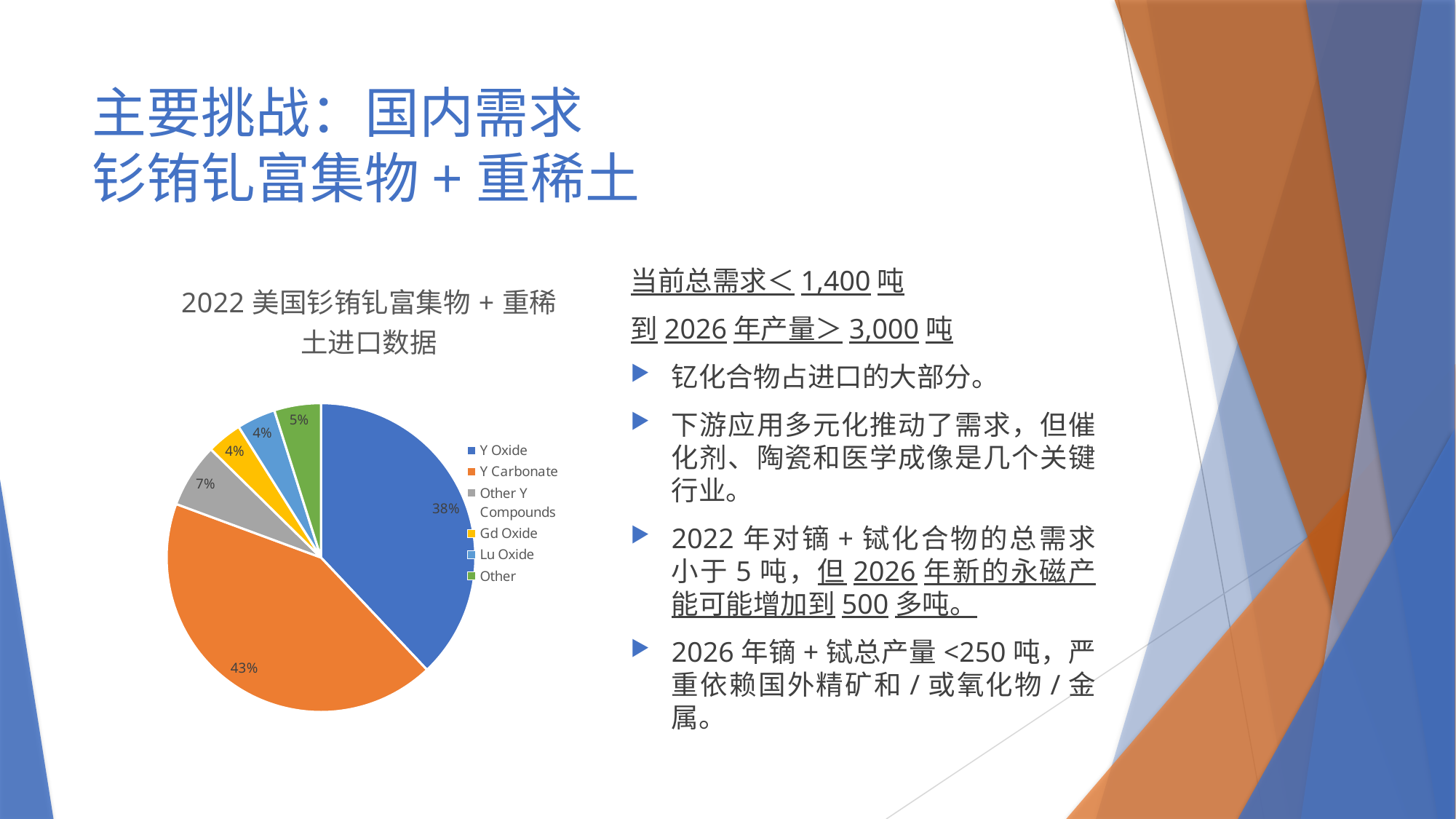
What share of the pie does the Other slice have? 5% What is the combined share of Y Oxide and Y Carbonate? 81% What share of the pie does Gd Oxide have? 4% Which category has the largest slice of the pie? Y Carbonate Which is larger, the Y Oxide slice or the Other Y Compounds slice? Y Oxide What colour is the Gd Oxide slice in the pie chart? yellow What kind of chart is shown on the slide? pie chart What is the difference in percentage points between the Y Carbonate and Y Oxide slices? 5 How many categories does the pie chart show? 6 What share of the pie does Y Carbonate have? 43%